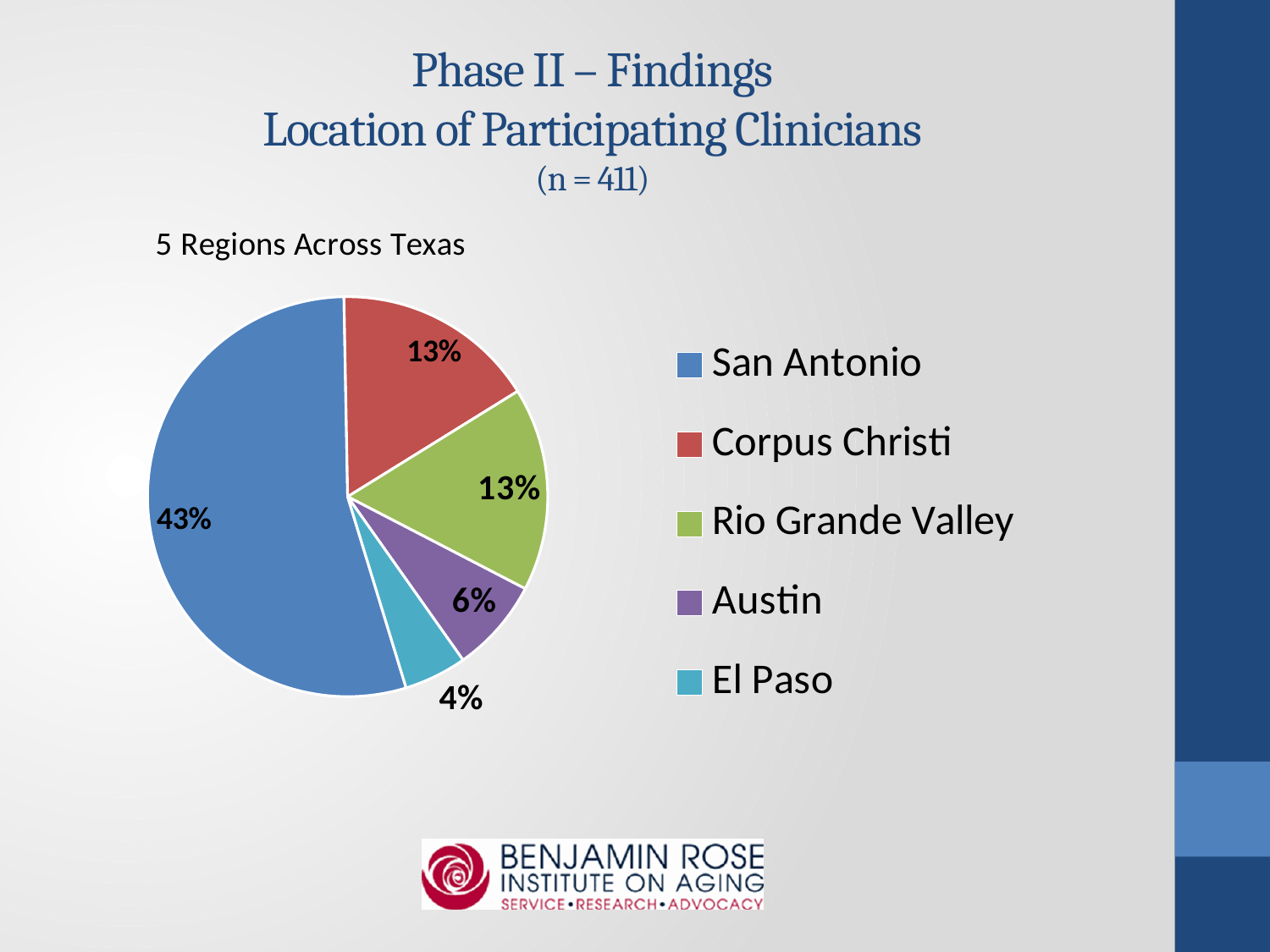
Which region has the smallest slice of the pie? El Paso What is the title shown above the pie chart? 5 Regions Across Texas What kind of chart is shown on the slide? Pie chart What is the difference in percentage points between San Antonio and Rio Grande Valley? 30 What percentage is shown for El Paso? 4% Which region has the largest slice of the pie? San Antonio What percentage is shown for Austin? 6% How many entries does the legend list? 5 How many regions are shown in the pie chart? 5 Which is larger, the share for Austin or the share for El Paso? Austin What share of participating clinicians is from San Antonio? 43% What percentage is shown for Corpus Christi? 13%